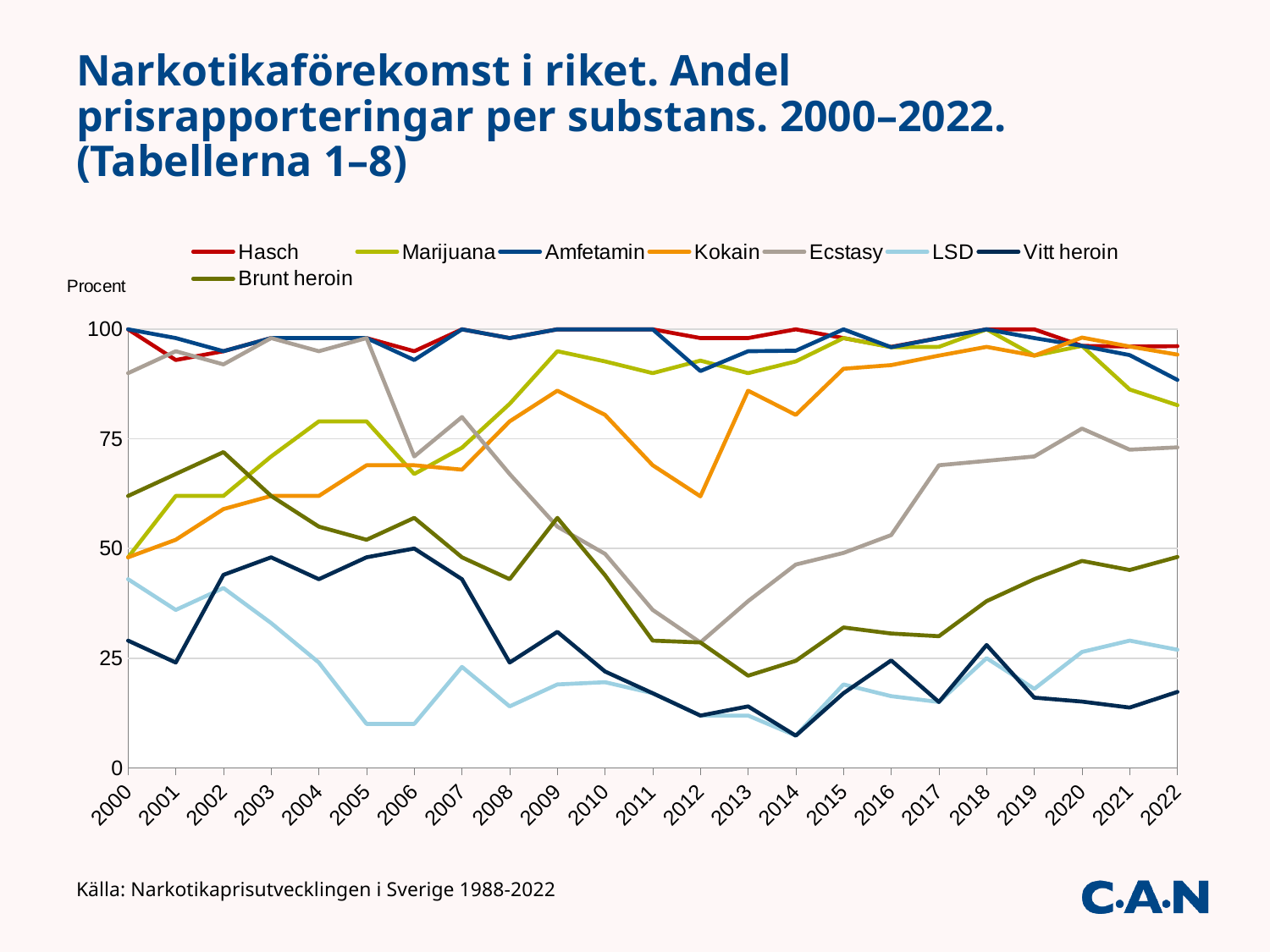
What kind of chart is shown on the slide? line chart How many series does the legend list? 8 In 2022, which is larger: Kokain or Brunt heroin? Kokain Is the value for Kokain in 2013 greater or less than 75? greater Which series is shown in light blue in the legend? LSD Does the Ecstasy line rise or fall between 2005 and 2012? fall How many years are plotted along the x axis? 23 Is the value for LSD in 2005 greater or less than 25? less Which series has the lowest value in 2005? LSD What is the label on the vertical axis? Procent Is the value for Vitt heroin in 2014 greater or less than 25? less